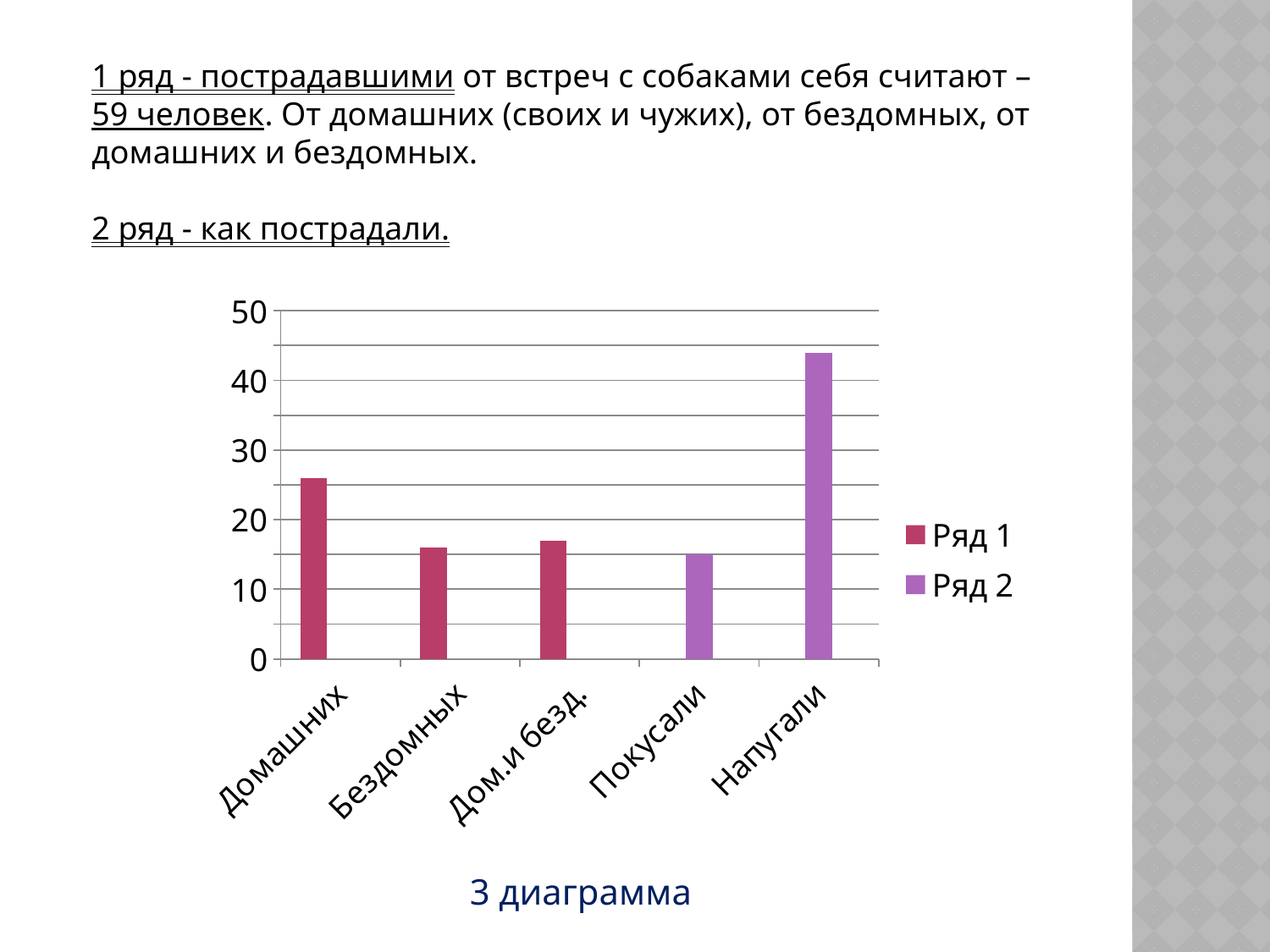
Which is larger, the value for Напугали or the value for Домашних? Напугали How many categories are shown on the x axis of the chart? 5 Which is larger, the value for Домашних or the value for Бездомных? Домашних Is the value for Дом.и безд. greater or less than 20? less What are the names of the two series in the chart legend? Ряд 1 and Ряд 2 Which category has the highest bar in the chart? Напугали Is the value for Напугали greater or less than 40? greater How many series does the chart legend list? 2 Is the value for Покусали greater or less than 20? less What kind of chart is shown on the slide? bar chart